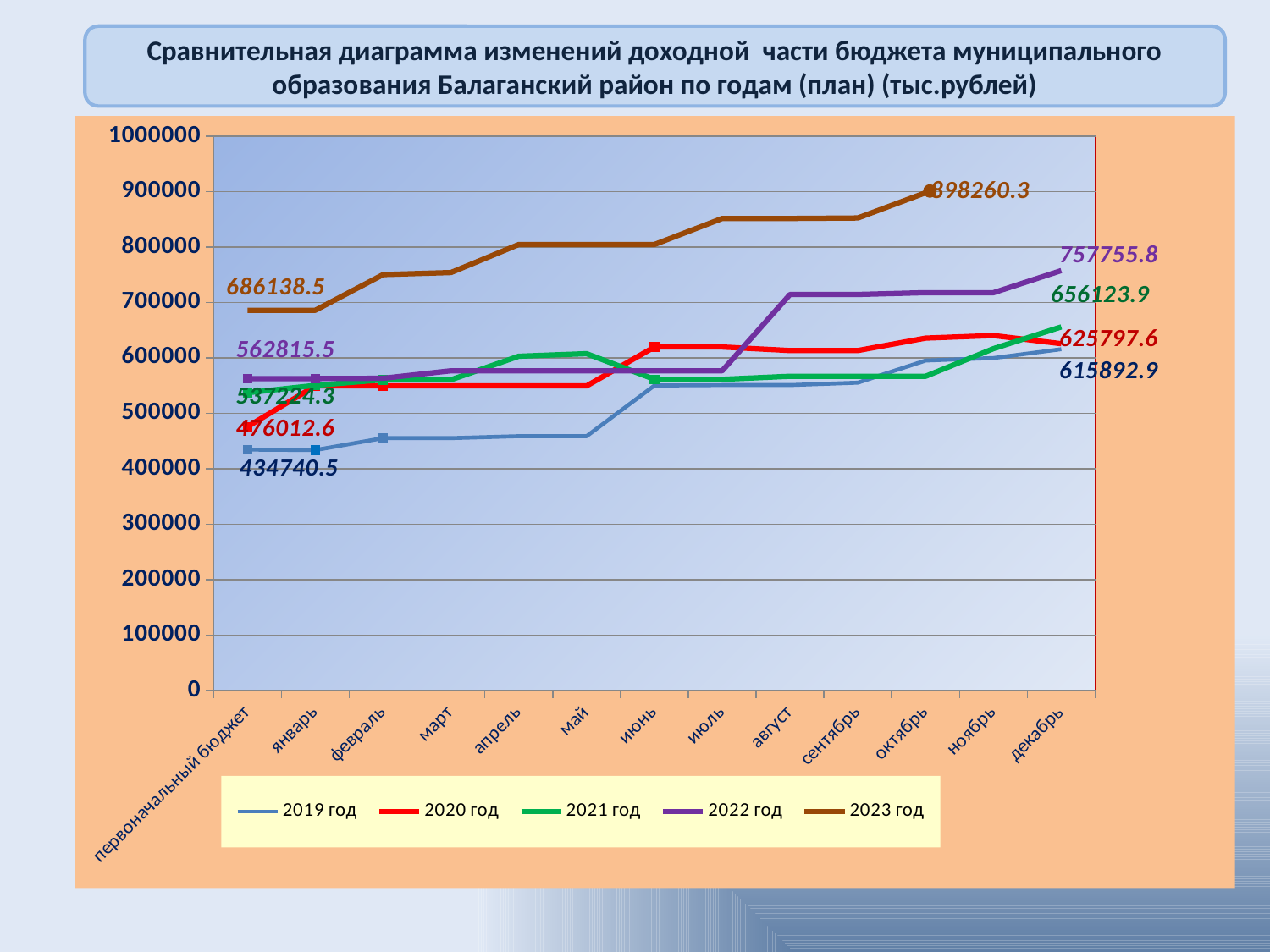
Is the value for 2023 год at август greater or less than 800000? greater How many categories are shown along the x axis? 13 Which is larger at декабрь: the value for 2021 год or the value for 2020 год? 2021 год Does the 2023 год line generally rise or fall from первоначальный бюджет to октябрь? rise What is the value for 2023 год at первоначальный бюджет? 686138.5 What kind of chart is shown on the slide? line chart How many series does the legend list? 5 What is the value for 2019 год at первоначальный бюджет? 434740.5 Which series has the highest value at первоначальный бюджет? 2023 год By how much does the 2023 год value at октябрь (898260.3) exceed its value at первоначальный бюджет (686138.5)? 212121.8 What is the value for 2022 год at декабрь? 757755.8 Which series has the lowest value at первоначальный бюджет? 2019 год